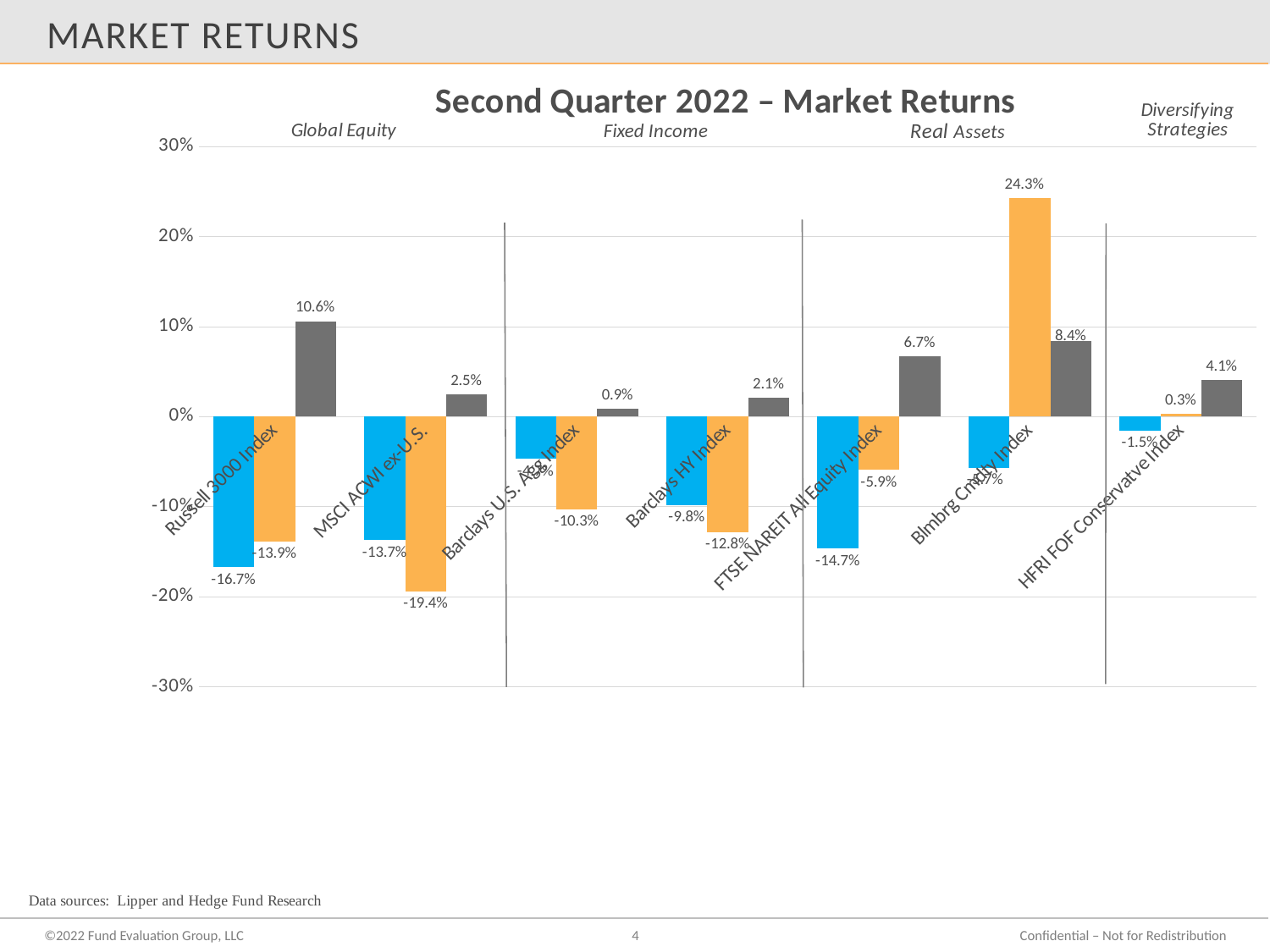
What kind of chart is shown on the slide? Bar chart What is the value of the orange bar for the Blmbrg Cmdty Index? 24.3% Which index has the lowest value shown on the chart? MSCI ACWI ex-U.S. Is the orange bar for the Blmbrg Cmdty Index greater or less than 20%? greater What is the value of the blue bar for the FTSE NAREIT All Equity Index? -14.7% What is the difference between the blue bar and the orange bar for the Russell 3000 Index? 2.8% Which index has the highest value shown on the chart? Blmbrg Cmdty Index Which is larger: the gray bar for the Barclays HY Index or the gray bar for the Barclays U.S. Agg Index? Barclays HY Index What is the value of the orange bar for MSCI ACWI ex-U.S.? -19.4% What is the value of the gray bar for the Russell 3000 Index? 10.6% What is the title of the chart? Second Quarter 2022 – Market Returns How many indexes are shown on the x axis of the chart? 7